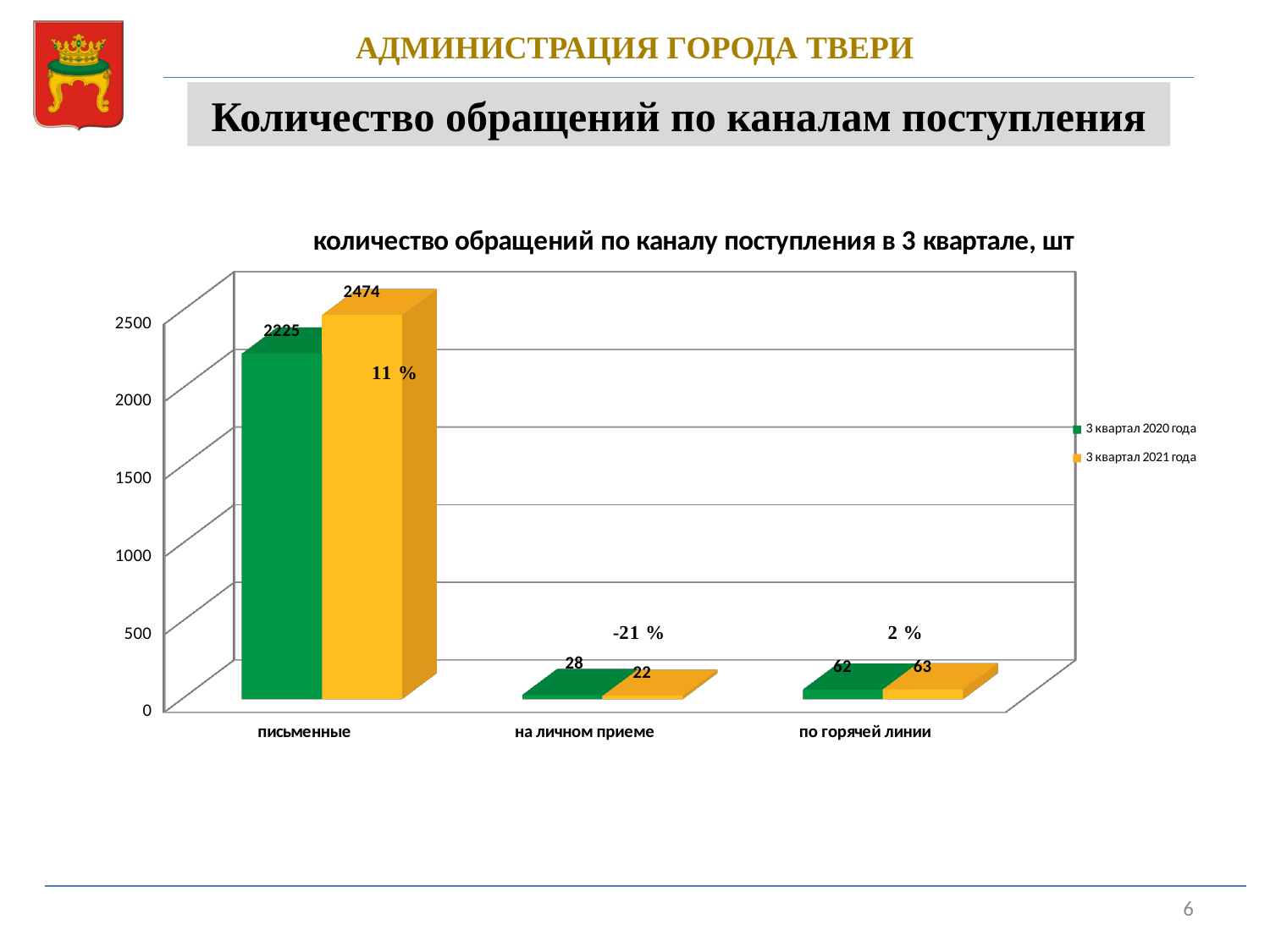
How many categories are shown on the x axis? 3 What is the value for на личном приеме in the 3 квартал 2021 года series? 22 What is the value for письменные in the 3 квартал 2021 года series? 2474 What kind of chart is shown on the slide? bar chart For на личном приеме, which series has the larger value: 3 квартал 2020 года or 3 квартал 2021 года? 3 квартал 2020 года What is the value for по горячей линии in the 3 квартал 2020 года series? 62 How many series does the legend list? 2 Which category has the lowest value in the 3 квартал 2020 года series? на личном приеме Which category has the highest value in the 3 квартал 2021 года series? письменные What percentage change is printed above the bars for на личном приеме? -21 % What is the value for письменные in the 3 квартал 2020 года series? 2225 What is the difference between the 3 квартал 2021 года and 3 квартал 2020 года values for письменные? 249